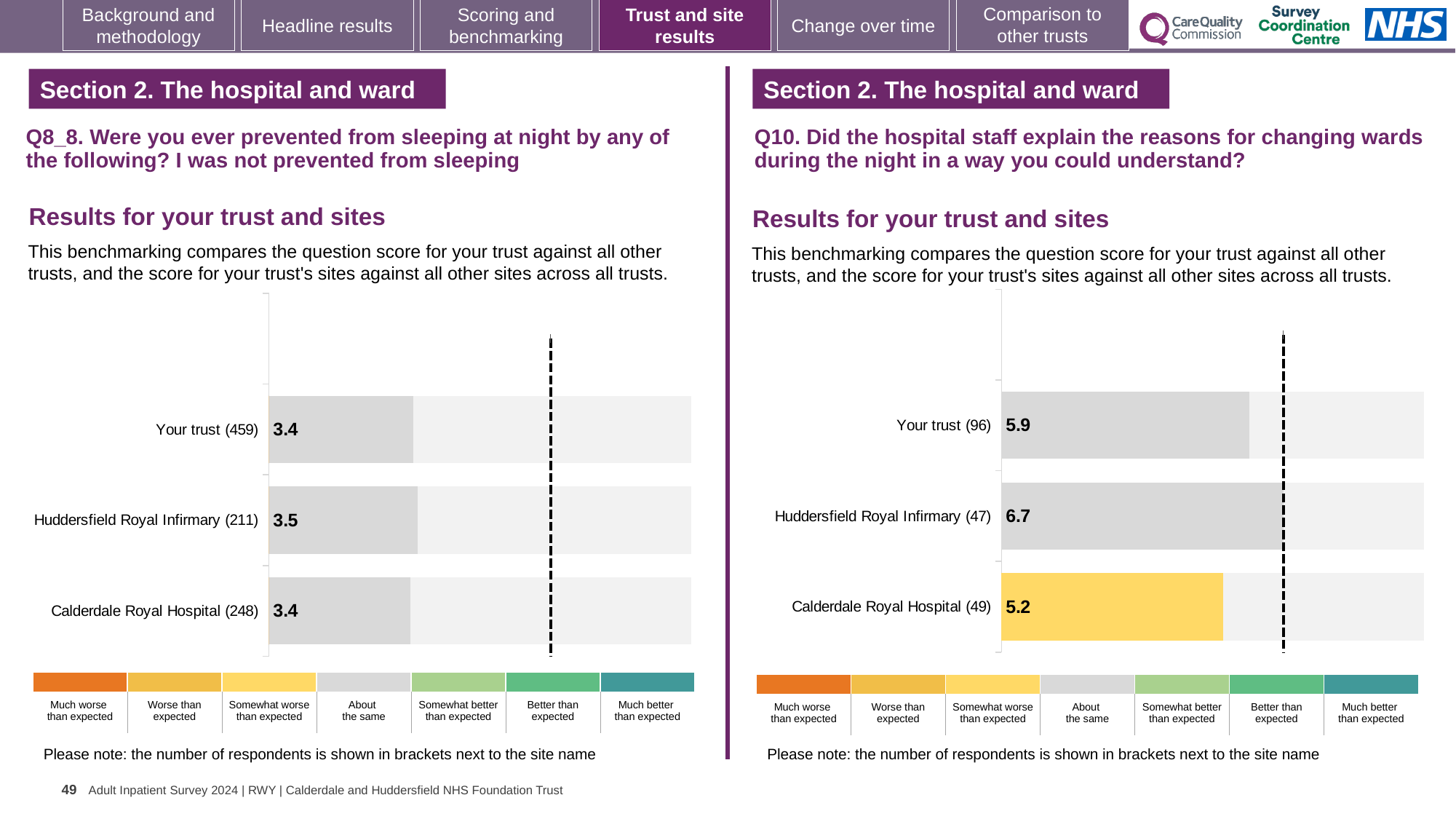
How many bars are plotted in the Q8_8 chart on the left? 3 In the Q8_8 chart on the left, what is the score for Huddersfield Royal Infirmary (211)? 3.5 In the Q10 chart on the right, what is the score for Huddersfield Royal Infirmary (47)? 6.7 In the Q10 chart on the right, what is the difference between the scores for Huddersfield Royal Infirmary (47) and Calderdale Royal Hospital (49)? 1.5 In the Q8_8 chart on the left, what is the score for Your trust (459)? 3.4 In the Q10 chart on the right, which site or trust has the lowest score? Calderdale Royal Hospital (49) What kind of chart is used in the Q10 chart on the right? Bar chart In the Q8_8 chart on the left, what is the difference between the scores for Huddersfield Royal Infirmary (211) and Calderdale Royal Hospital (248)? 0.1 In the Q10 chart on the right, what is the score for Calderdale Royal Hospital (49)? 5.2 In the Q10 chart on the right, which benchmark category does the yellow colour of the Calderdale Royal Hospital (49) bar indicate? Somewhat worse than expected In the Q10 chart on the right, which site or trust has the highest score? Huddersfield Royal Infirmary (47) In the Q10 chart on the right, which is larger: the score for Your trust (96) or the score for Calderdale Royal Hospital (49)? Your trust (96)